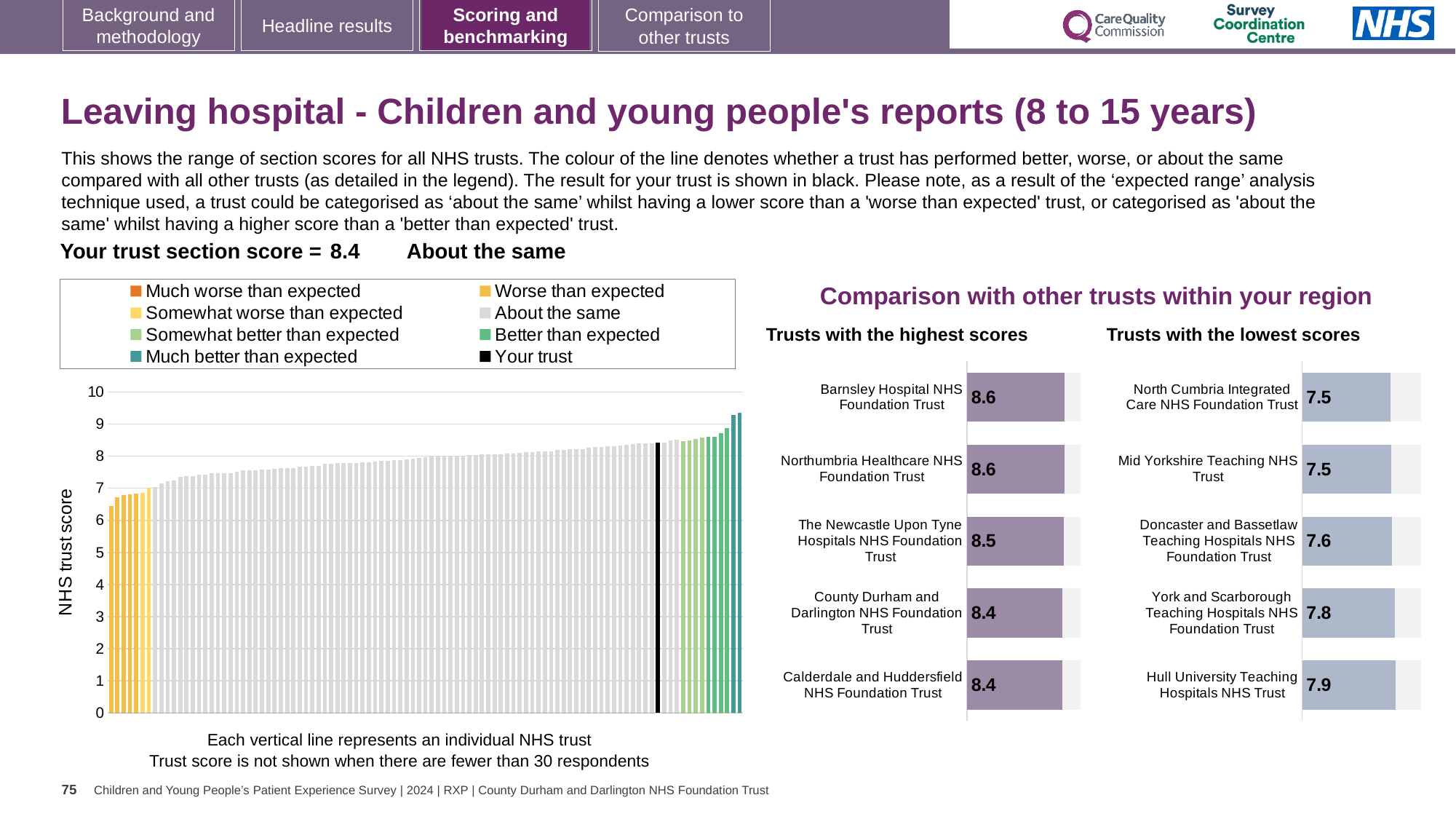
What is the difference between Barnsley Hospital NHS Foundation Trust's score in the 'highest scores' chart and Hull University Teaching Hospitals NHS Trust's score in the 'lowest scores' chart? 0.7 What is the y-axis label of the large chart on the left? NHS trust score How many entries does the legend of the large chart on the left list? 8 In the 'Trusts with the lowest scores' chart, what is the score for York and Scarborough Teaching Hospitals NHS Foundation Trust? 7.8 In the large chart on the left, do the trust scores rise or fall from left to right? Rise How many trusts are shown in the 'Trusts with the lowest scores' chart? 5 Which has the larger score: The Newcastle Upon Tyne Hospitals NHS Foundation Trust in the 'highest scores' chart or York and Scarborough Teaching Hospitals NHS Foundation Trust in the 'lowest scores' chart? The Newcastle Upon Tyne Hospitals NHS Foundation Trust What kind of chart is the large chart on the left showing NHS trust scores? Bar chart In the 'Trusts with the lowest scores' chart, which trust has the highest score? Hull University Teaching Hospitals NHS Trust In the 'Trusts with the highest scores' chart, what is the score for The Newcastle Upon Tyne Hospitals NHS Foundation Trust? 8.5 In the 'Trusts with the highest scores' chart, what is the score for Barnsley Hospital NHS Foundation Trust? 8.6 In the large chart on the left, is the value of the leftmost bar greater or less than 7? less